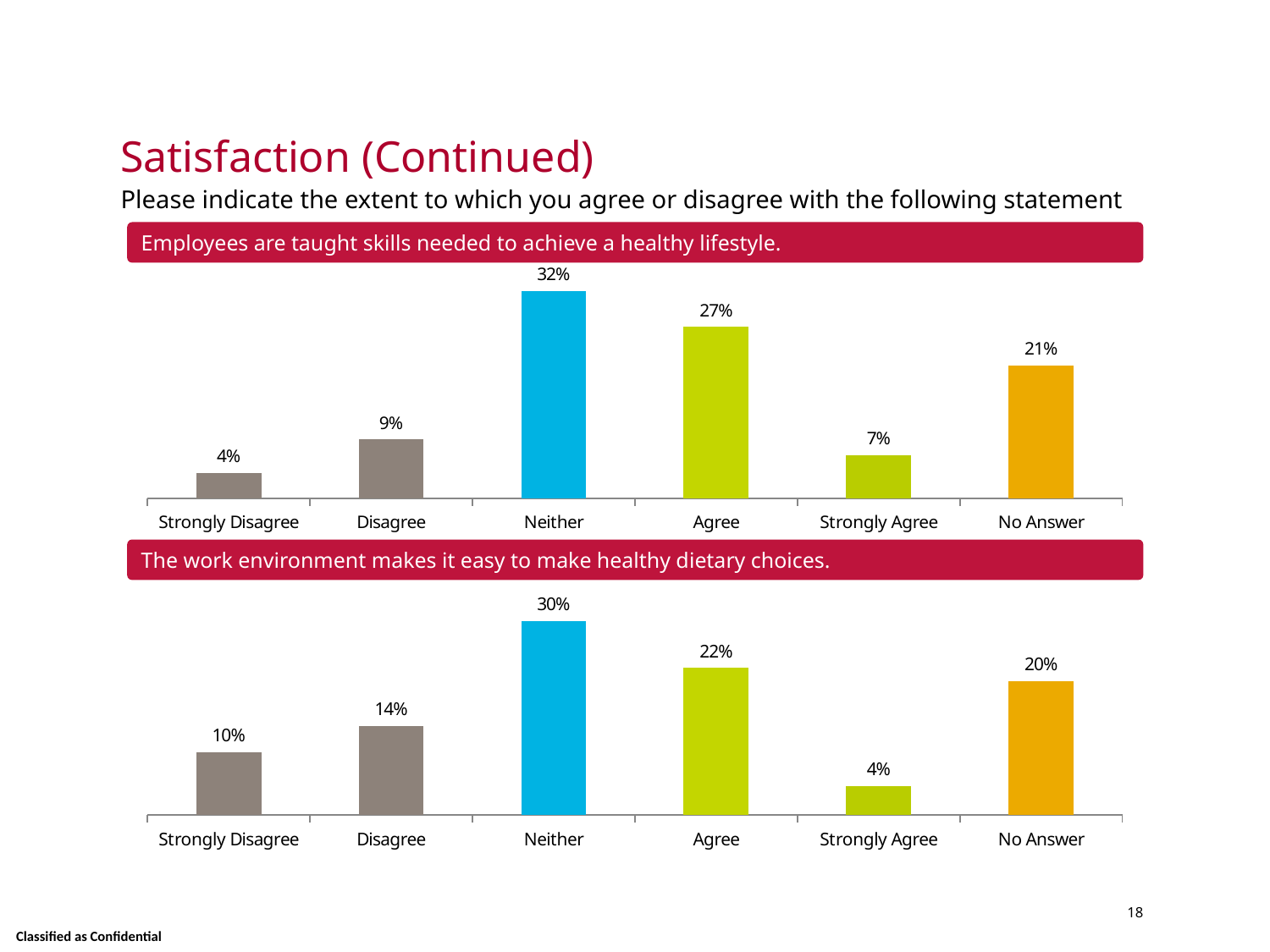
In the chart titled 'Employees are taught skills needed to achieve a healthy lifestyle.', which category has the highest value? Neither How many categories are shown in the chart titled 'Employees are taught skills needed to achieve a healthy lifestyle.'? 6 In the chart titled 'Employees are taught skills needed to achieve a healthy lifestyle.', what is the value for Strongly Agree? 7% In the chart titled 'The work environment makes it easy to make healthy dietary choices.', what is the difference between Neither and Agree? 8% In the chart titled 'Employees are taught skills needed to achieve a healthy lifestyle.', what is the value for Neither? 32% In the chart titled 'The work environment makes it easy to make healthy dietary choices.', what is the value for Disagree? 14% In the chart titled 'Employees are taught skills needed to achieve a healthy lifestyle.', which category has the lowest value? Strongly Disagree In the chart titled 'The work environment makes it easy to make healthy dietary choices.', what is the value for No Answer? 20% In the chart titled 'Employees are taught skills needed to achieve a healthy lifestyle.', what is the difference between Agree and No Answer? 6% In the chart titled 'The work environment makes it easy to make healthy dietary choices.', which category has the lowest value? Strongly Agree What kind of chart is the chart titled 'The work environment makes it easy to make healthy dietary choices.'? Bar chart In the chart titled 'The work environment makes it easy to make healthy dietary choices.', which is larger, Strongly Disagree or Disagree? Disagree